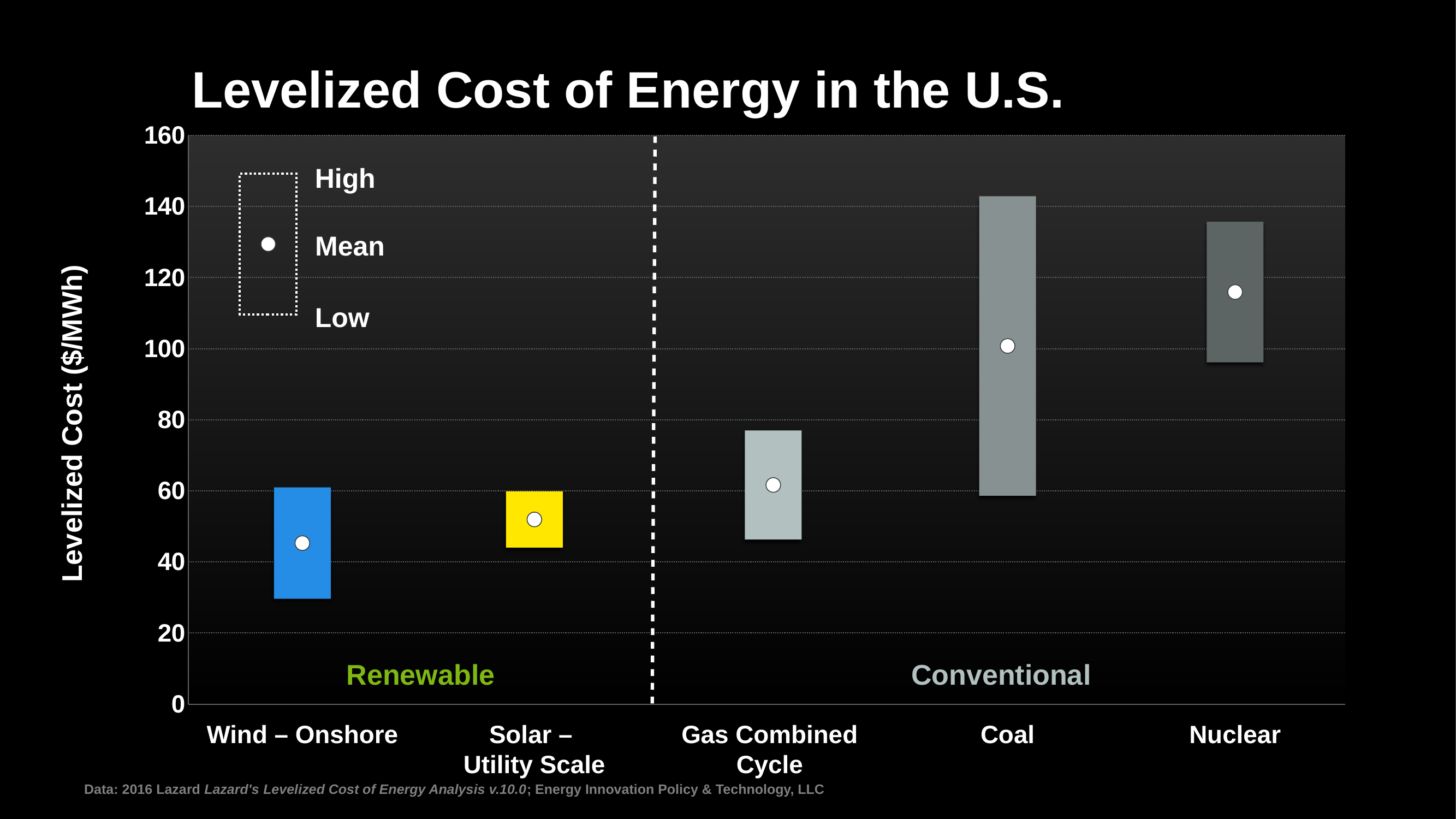
What kind of chart is shown on the slide? bar chart Which energy source has the highest mean levelized cost? Nuclear Which energy source has the lowest 'Low' levelized cost? Wind – Onshore Is the 'Low' value for Nuclear greater or less than 100? less Which has the larger mean levelized cost, Gas Combined Cycle or Solar – Utility Scale? Gas Combined Cycle Is the 'High' value for Gas Combined Cycle greater or less than 80? less Which energy sources are grouped under the 'Renewable' label? Wind – Onshore and Solar – Utility Scale How many energy source categories are shown on the x axis? 5 Which energy source has the highest 'High' levelized cost? Coal Is the 'High' value for Coal greater or less than 140? greater Which energy source has the lowest mean levelized cost? Wind – Onshore